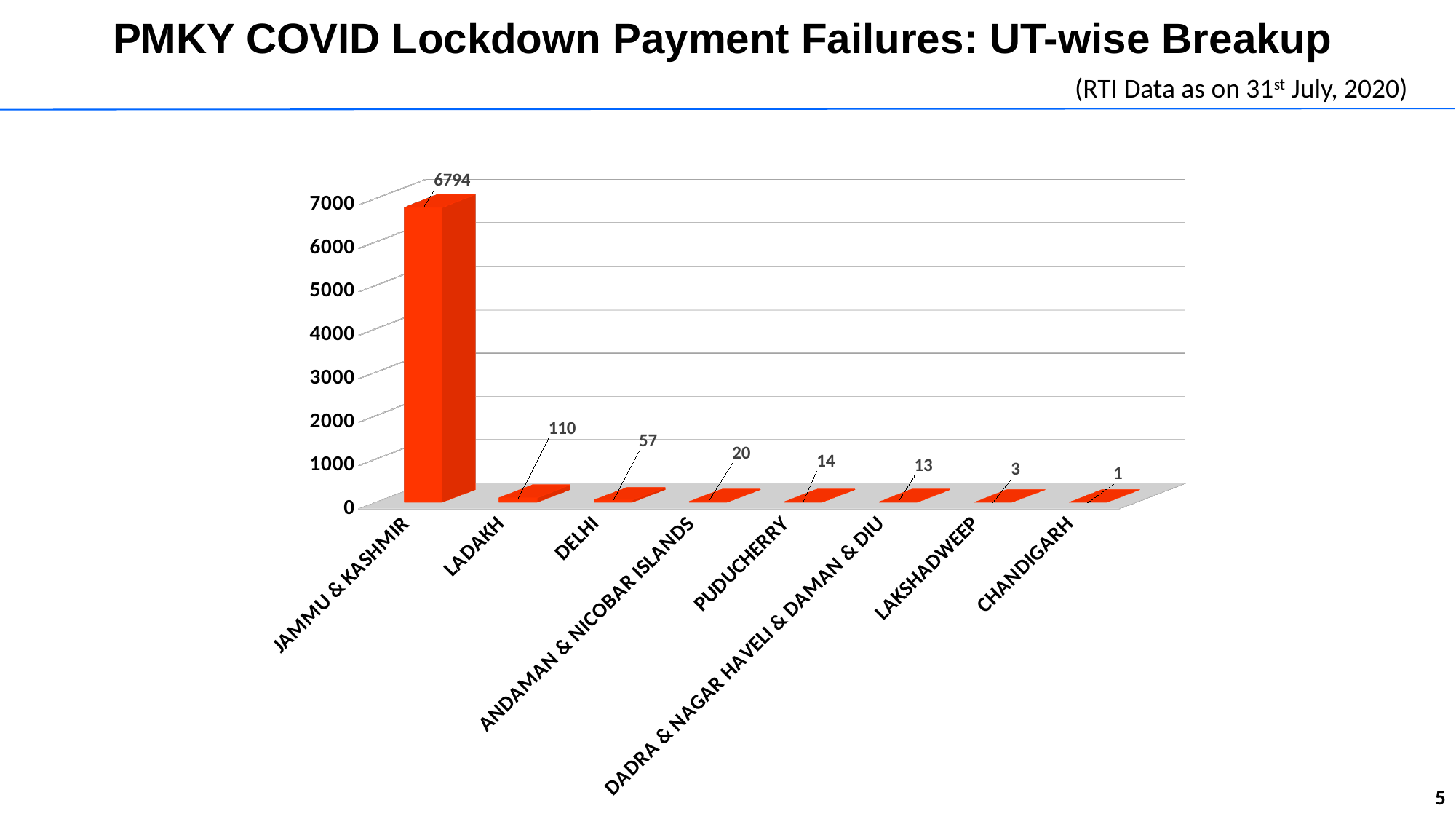
What is the value for Dadra & Nagar Haveli & Daman & Diu? 13 What is the value for Delhi? 57 Which is larger, the value for Puducherry or the value for Lakshadweep? Puducherry What is the value for Jammu & Kashmir? 6794 Do the values rise or fall from left to right along the x axis? Fall What is the value for Ladakh? 110 What is the difference between the values for Ladakh and Delhi? 53 How many UTs are shown on the chart? 8 Which UT has the highest number of payment failures? Jammu & Kashmir Which UT has the lowest number of payment failures? Chandigarh What kind of chart is shown on the slide? Bar chart What is the value for Andaman & Nicobar Islands? 20